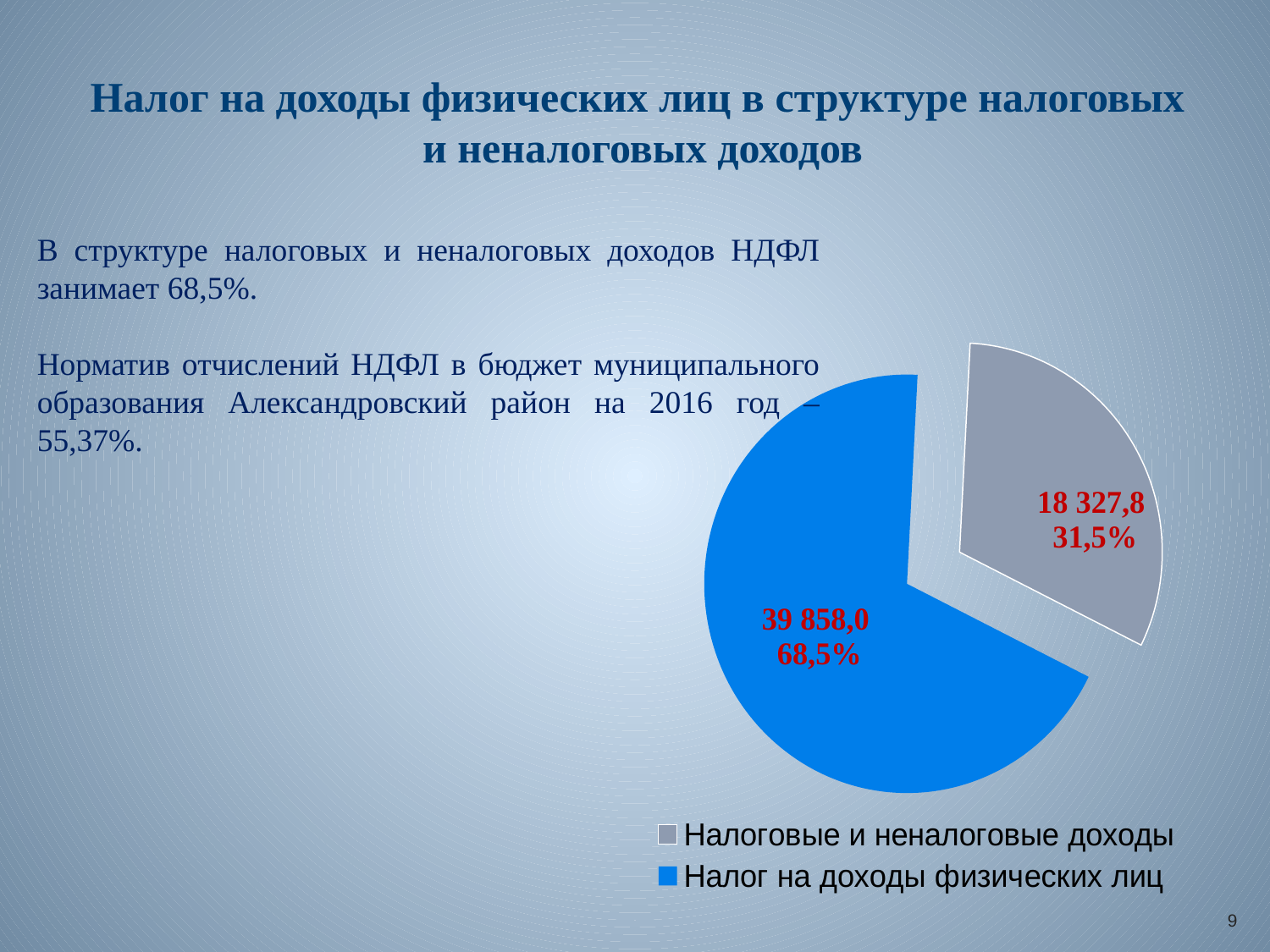
What share of the pie does the slice "Налог на доходы физических лиц" take? 68,5% What colour is the slice for "Налог на доходы физических лиц"? blue What is the value shown for the slice "Налог на доходы физических лиц"? 39 858,0 How many entries does the legend list? 2 What kind of chart is shown on the slide? pie chart What share of the pie does the slice "Налоговые и неналоговые доходы" take? 31,5% What is the value shown for the slice "Налоговые и неналоговые доходы"? 18 327,8 Which is larger: the value for "Налог на доходы физических лиц" or the value for "Налоговые и неналоговые доходы"? Налог на доходы физических лиц Which slice of the pie is the smallest? Налоговые и неналоговые доходы How many slices does the pie chart have? 2 What is the difference between the values for "Налог на доходы физических лиц" and "Налоговые и неналоговые доходы"? 21 530,2 Which slice of the pie is the largest? Налог на доходы физических лиц